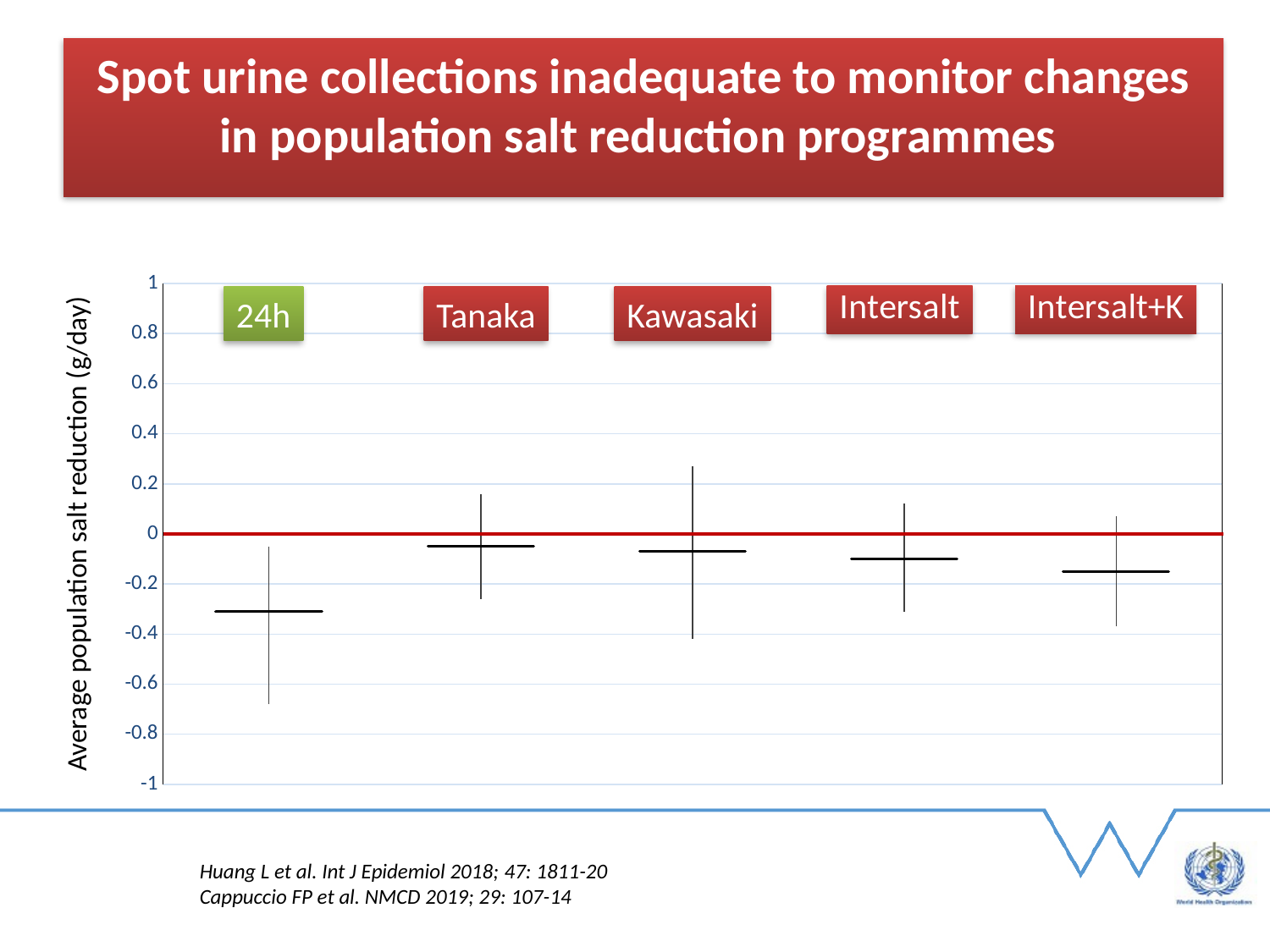
Is the value for Tanaka greater or less than -0.2? greater Which category label on the chart is shown in a green box rather than a red one? 24h How many categories are plotted on the chart? 5 Which category has the lowest average population salt reduction on the chart? 24h Which is larger, the value for 24h or the value for Intersalt+K? Intersalt+K What is the label on the vertical axis of the chart? Average population salt reduction (g/day) Which is larger, the value for 24h or the value for Tanaka? Tanaka Which is larger, the value for Tanaka or the value for Intersalt? Tanaka Is the value for Kawasaki greater or less than 0? less Is the value for Intersalt+K greater or less than 0? less